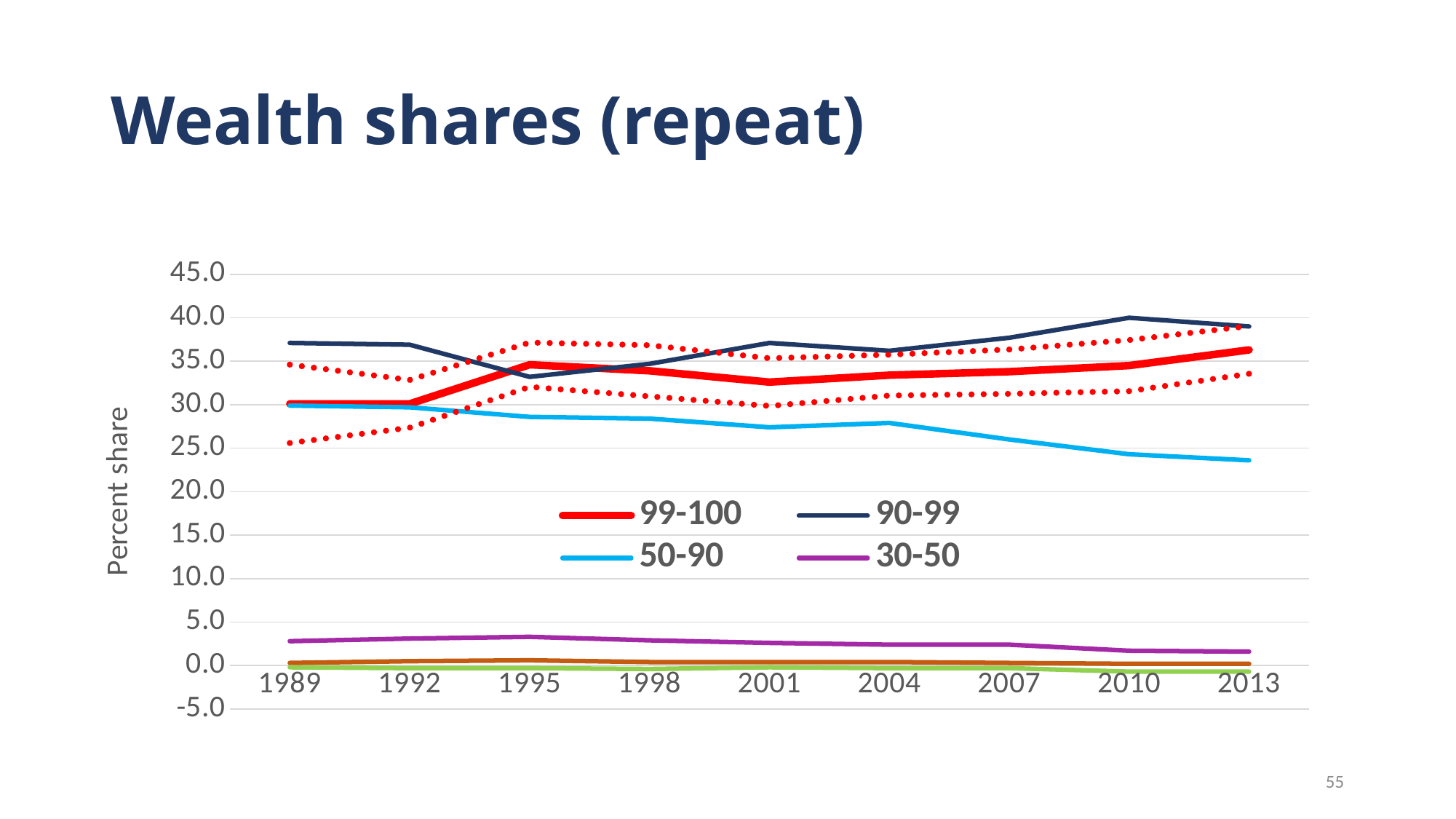
Which legend series has the highest value in 2010? 90-99 What is the label on the vertical axis of the chart? Percent share Is the value for the 30-50 series in 1995 greater or less than 5.0? less Does the 50-90 series rise or fall from 1989 to 2013? fall Is the value for the 50-90 series in 2013 greater or less than 25.0? less How many series does the legend list? 4 Is the value for the 50-90 series in 1989 greater or less than 25.0? greater What is the title of the chart on the slide? Wealth shares (repeat) How many years are labelled along the x axis? 9 In 2013, which is larger: the 90-99 series or the 50-90 series? 90-99 What kind of chart is shown on the slide? line chart